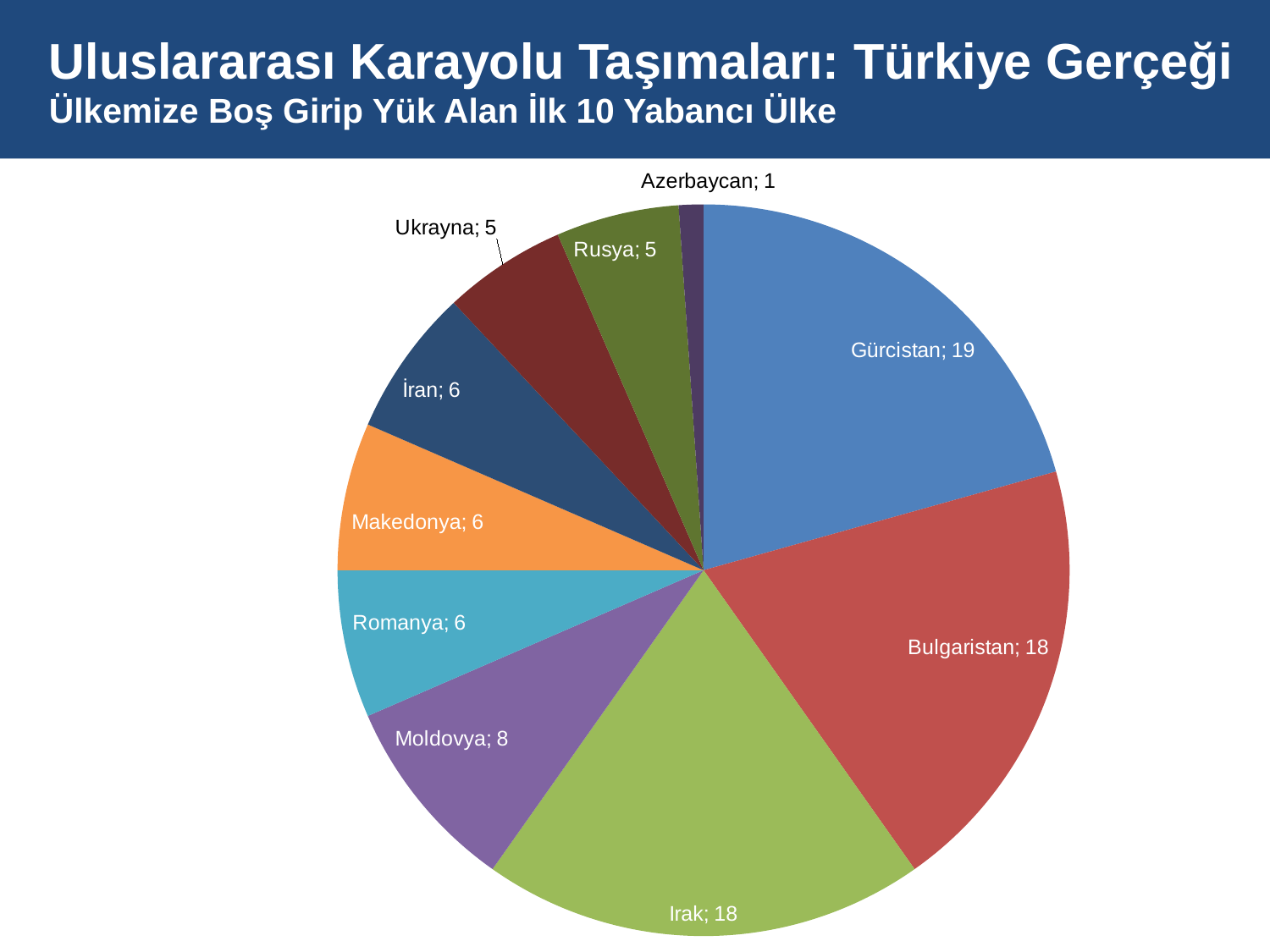
How many countries are shown in the pie chart? 10 What is the difference between the values for Bulgaristan and Rusya? 13 Which country has the smallest slice of the pie? Azerbaycan What is the total of all the slices in the pie chart? 92 Which country has the largest slice of the pie? Gürcistan What is the subtitle of the slide describing the chart? Ülkemize Boş Girip Yük Alan İlk 10 Yabancı Ülke What is the value for Gürcistan? 19 Which is larger, the value for Moldovya or the value for Romanya? Moldovya What is the value for Moldovya? 8 What kind of chart is shown on the slide? pie chart What is the difference between the values for Gürcistan and Moldovya? 11 What is the value for Azerbaycan? 1